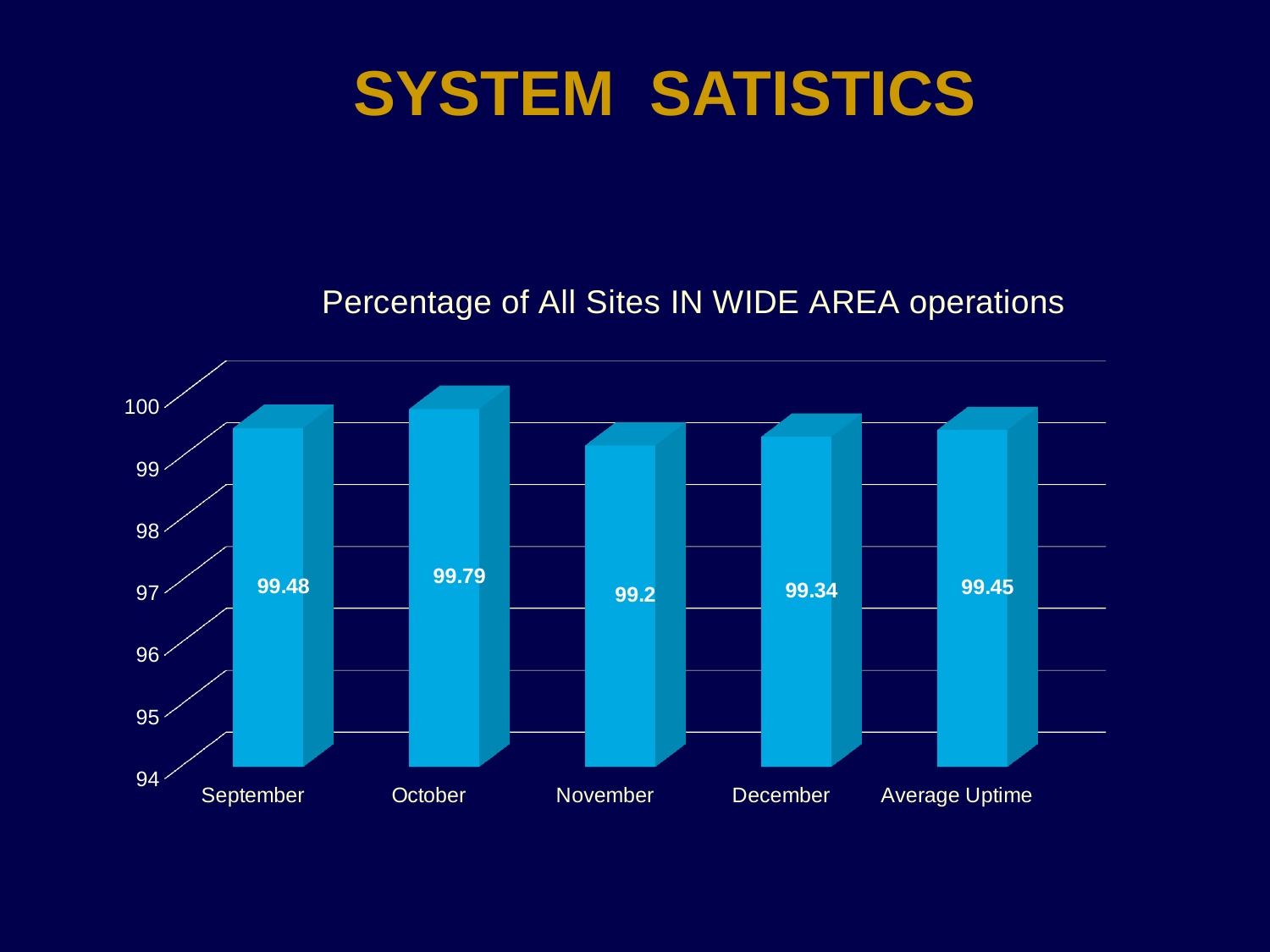
Which category has the lowest value? November Which category has the highest value? October What is the value for November? 99.2 What kind of chart is this? bar chart What is the title of the chart? Percentage of All Sites IN WIDE AREA operations What is the value for October? 99.79 What is the difference between the values for September and December? 0.14 What is the difference between the values for October and November? 0.59 Is the value for December greater or less than 99? greater How many categories are shown on the x axis? 5 What is the value for Average Uptime? 99.45 Which is larger, the value for September or the value for December? September